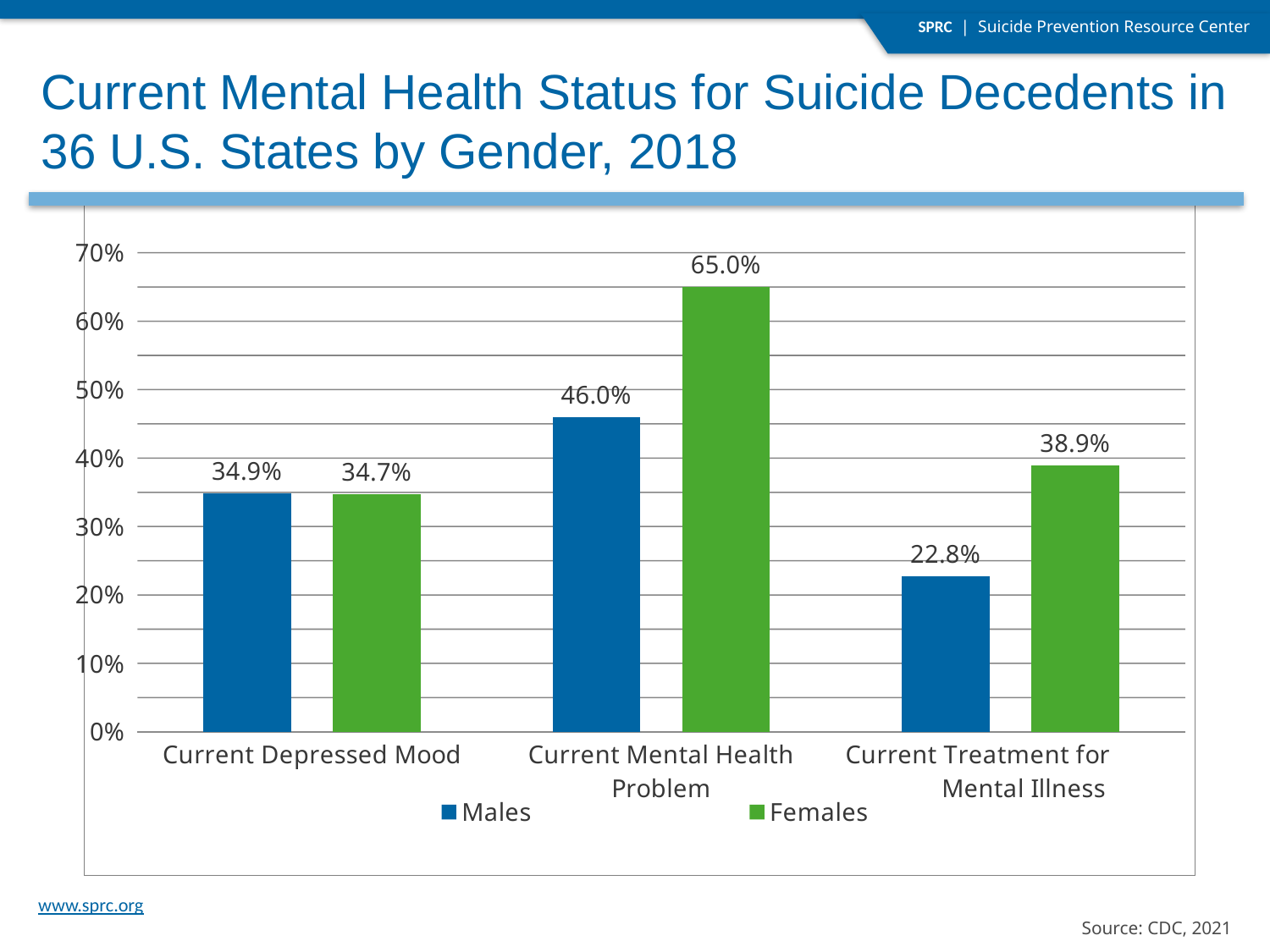
Which category has the lowest value for Males? Current Treatment for Mental Illness What is the difference between the Females and Males values in the Current Treatment for Mental Illness category? 16.1% What is the value for Females in the Current Treatment for Mental Illness category? 38.9% Which is larger in the Current Treatment for Mental Illness category, the Males value or the Females value? Females Which category has the highest value for Females? Current Mental Health Problem What kind of chart is shown on the slide? Bar chart How many series does the legend list? 2 What is the difference between the Females and Males values in the Current Mental Health Problem category? 19.0% What is the value for Males in the Current Depressed Mood category? 34.9% Is the value for Females in the Current Mental Health Problem category greater or less than 60%? greater How many categories are shown on the x axis? 3 What is the value for Males in the Current Mental Health Problem category? 46.0%